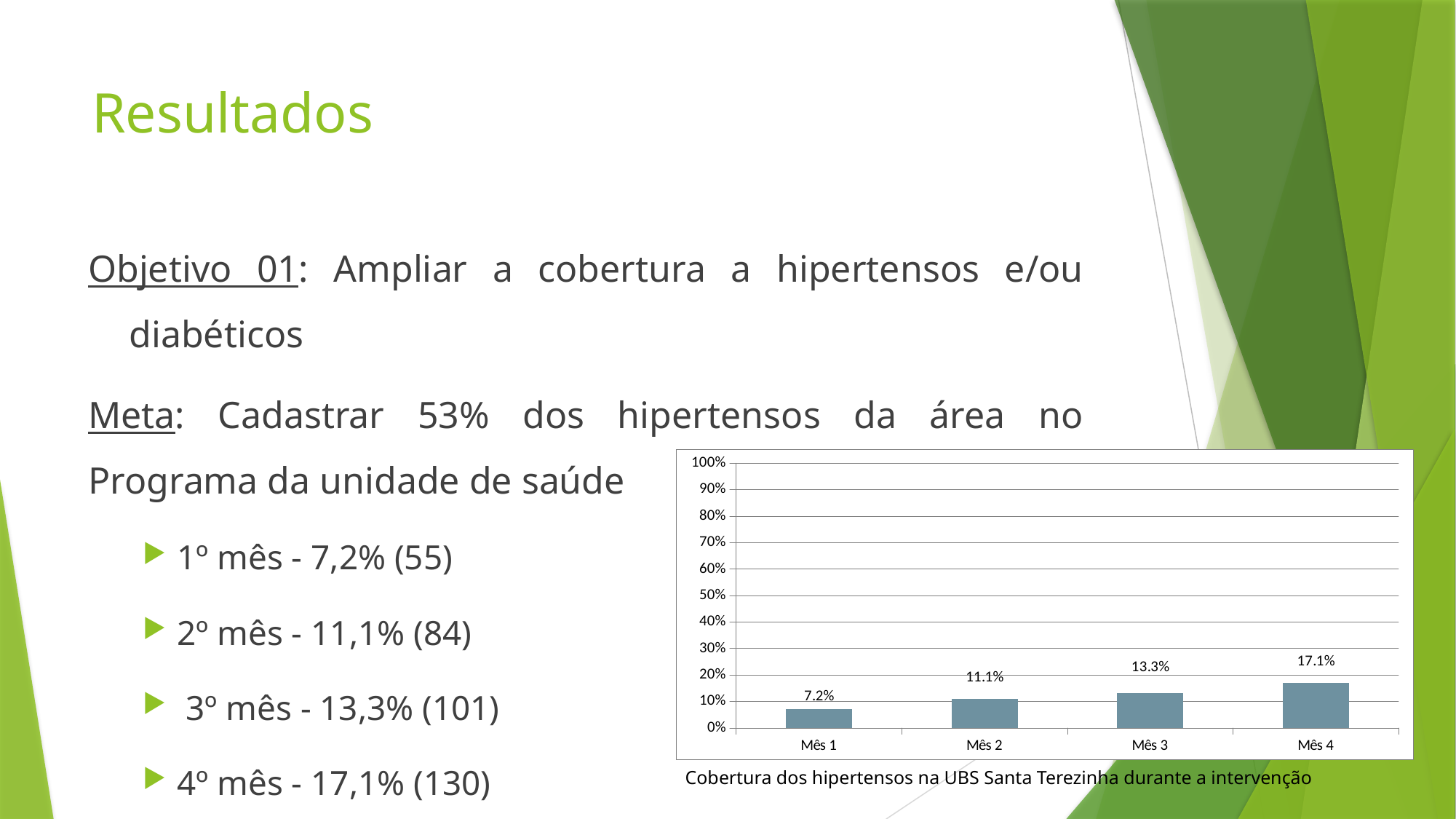
Which month has the highest value? Mês 4 What is the value for Mês 1? 7.2% Which is larger, the value for Mês 2 or the value for Mês 3? Mês 3 Do the values rise or fall from Mês 1 to Mês 4? rise Is the value for Mês 4 greater or less than 20%? less What is the value for Mês 4? 17.1% What is the value for Mês 2? 11.1% What is the value for Mês 3? 13.3% What is the difference between the values for Mês 4 and Mês 1? 9.9% What kind of chart is shown? bar chart Which month has the lowest value? Mês 1 How many months are shown on the x axis? 4